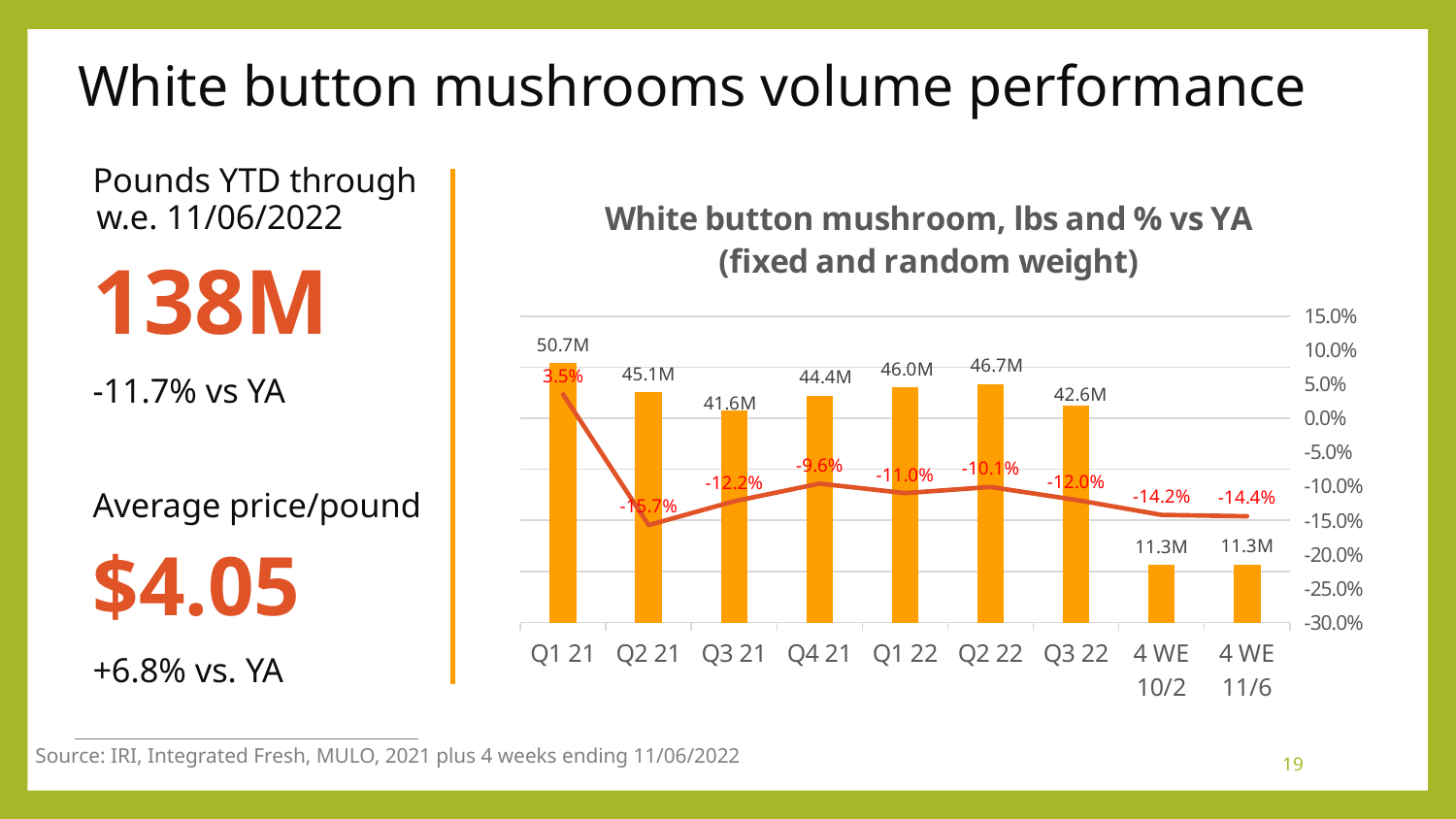
What is the volume in pounds for Q1 21? 50.7M What is the % vs YA value for Q2 21? -15.7% Is the % vs YA value for Q4 21 greater or less than -10.0%? greater What is the % vs YA value for the 4 WE 11/6 period? -14.4% What is the difference in pounds between Q1 21 and Q2 21? 5.6M What is the volume in pounds for Q2 22? 46.7M How many periods are shown on the x axis? 9 Which has the larger volume in pounds, Q3 21 or Q4 21? Q4 21 Which period has the lowest % vs YA value? Q2 21 What kind of chart is this? Combined bar and line chart What is the title of the chart? White button mushroom, lbs and % vs YA (fixed and random weight) Which period has the highest volume in pounds? Q1 21